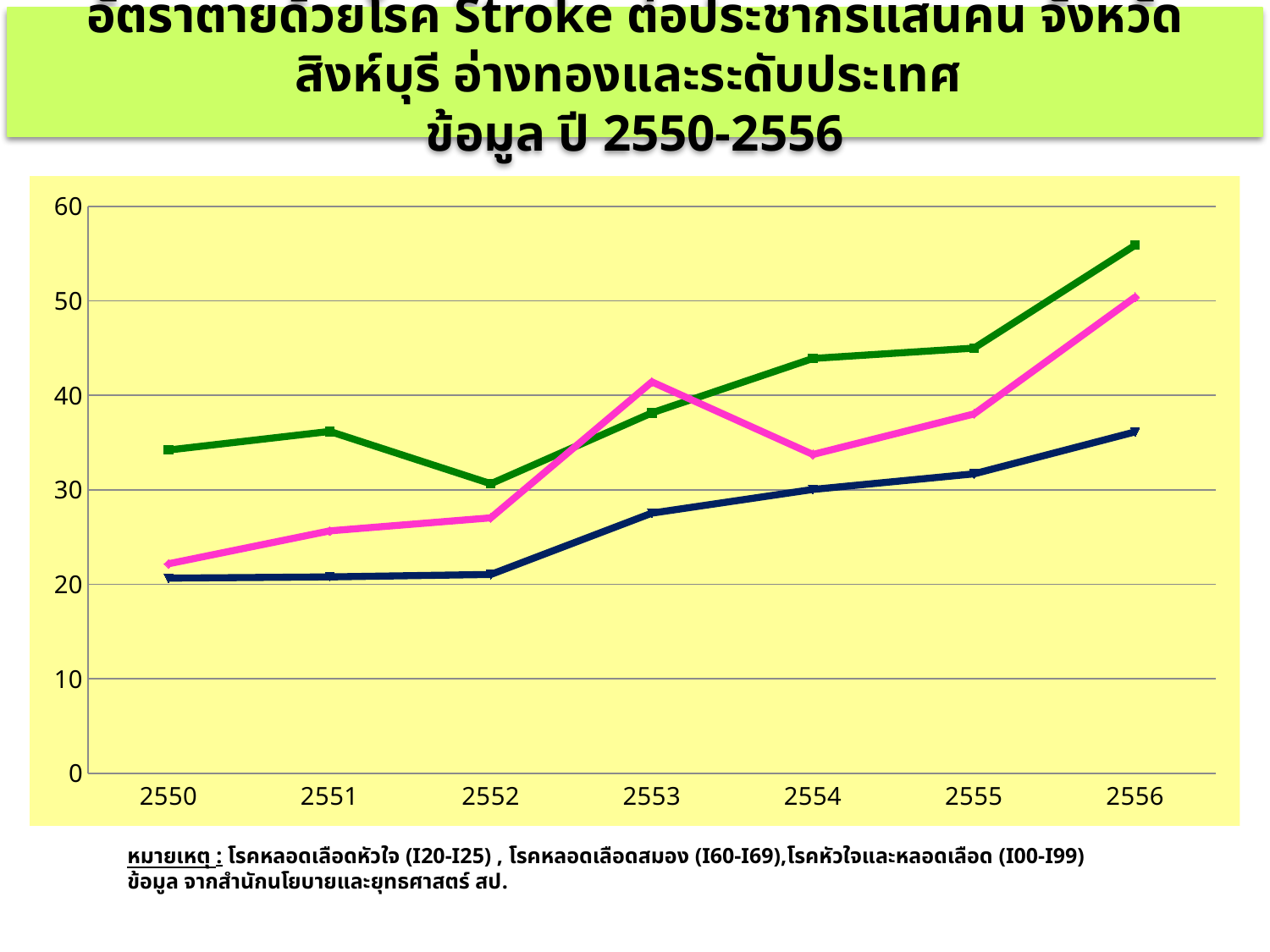
Is the value of the green line for 2554 greater or less than 40? greater In 2556, which line has the higher value, the green line or the pink line? green line In which year does the green line reach its highest value? 2556 Is the value of the dark blue line for 2556 greater or less than 30? greater How many lines are plotted on the chart? 3 Does the dark blue line rise or fall from 2550 to 2556? rise Is the value of the dark blue line for 2550 greater or less than 30? less How many years are shown along the x axis of the chart? 7 What kind of chart is shown on the slide? line chart In which year does the green line reach its lowest value? 2552